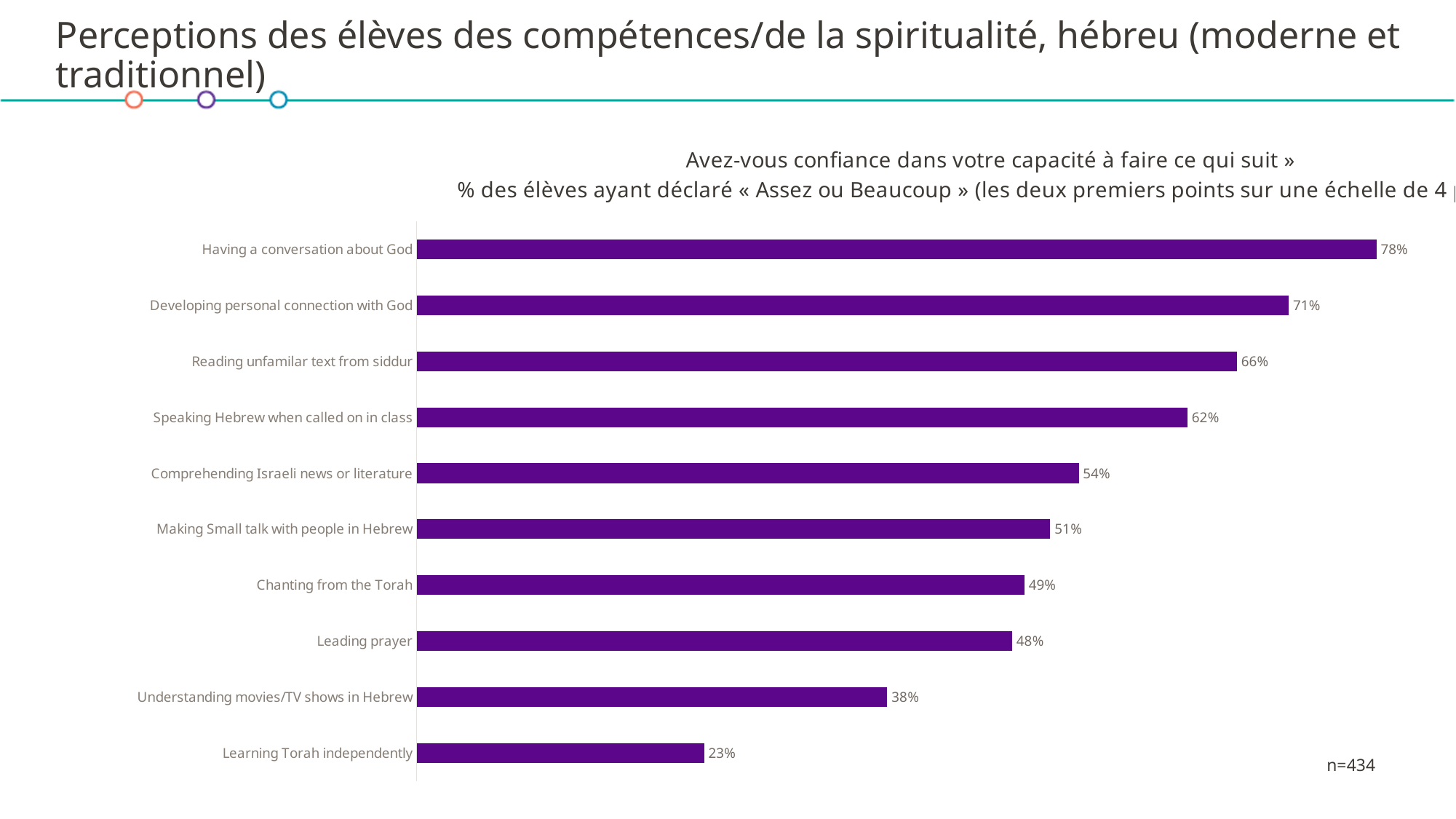
What is the value for Understanding movies/TV shows in Hebrew? 38% What is the difference between the values for Reading unfamilar text from siddur and Learning Torah independently? 43% What is the difference between the values for Developing personal connection with God and Leading prayer? 23% What colour are the bars in the chart? Purple Which is larger: the value for Speaking Hebrew when called on in class or the value for Comprehending Israeli news or literature? Speaking Hebrew when called on in class Which category has the lowest value? Learning Torah independently What sample size (n) is shown on the slide? n=434 What percentage of students reported confidence in having a conversation about God? 78% How many categories are shown in the chart? 10 Which category has the highest value? Having a conversation about God What kind of chart is shown on the slide? Bar chart What is the value for Chanting from the Torah? 49%